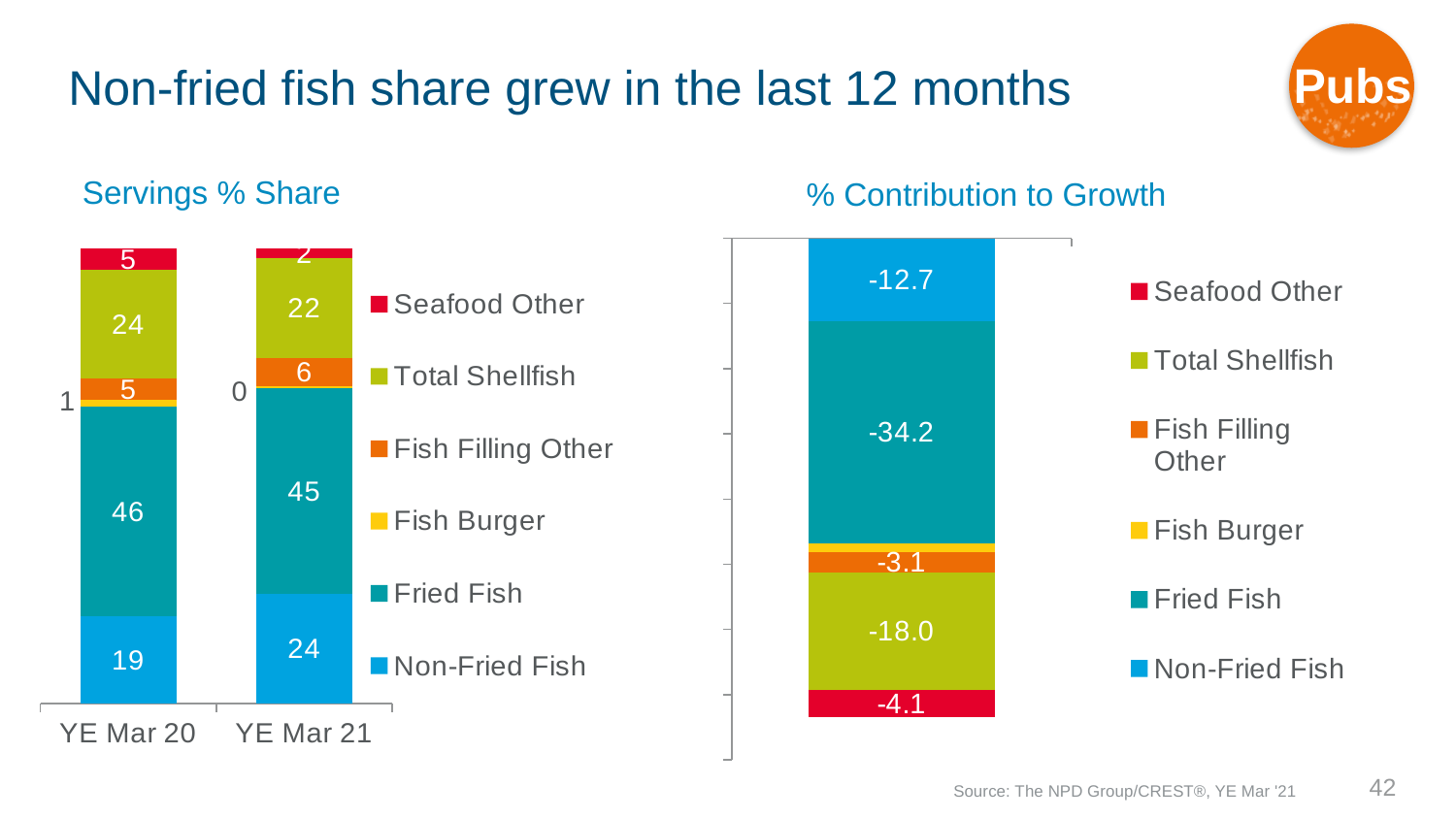
In the % Contribution to Growth chart, what is the value for Non-Fried Fish? -12.7 In the Servings % Share chart, what is the value for Fried Fish in YE Mar 20? 46 How many bars (categories) are shown on the x axis of the Servings % Share chart? 2 In the Servings % Share chart, what is the value for Total Shellfish in YE Mar 21? 22 In the Servings % Share chart, by how much did the Non-Fried Fish value increase from YE Mar 20 to YE Mar 21? 5 In the % Contribution to Growth chart, what is the value for Fried Fish? -34.2 In the Servings % Share chart, what is the value for Non-Fried Fish in YE Mar 21? 24 In the Servings % Share chart, which year has the larger Fried Fish value, YE Mar 20 or YE Mar 21? YE Mar 20 In the % Contribution to Growth chart, which labelled segment has the lowest (most negative) value? Fried Fish In the Servings % Share chart, what is the value for Seafood Other in YE Mar 20? 5 How many series does the legend of the Servings % Share chart list? 6 What kind of chart is the % Contribution to Growth chart? Stacked bar chart